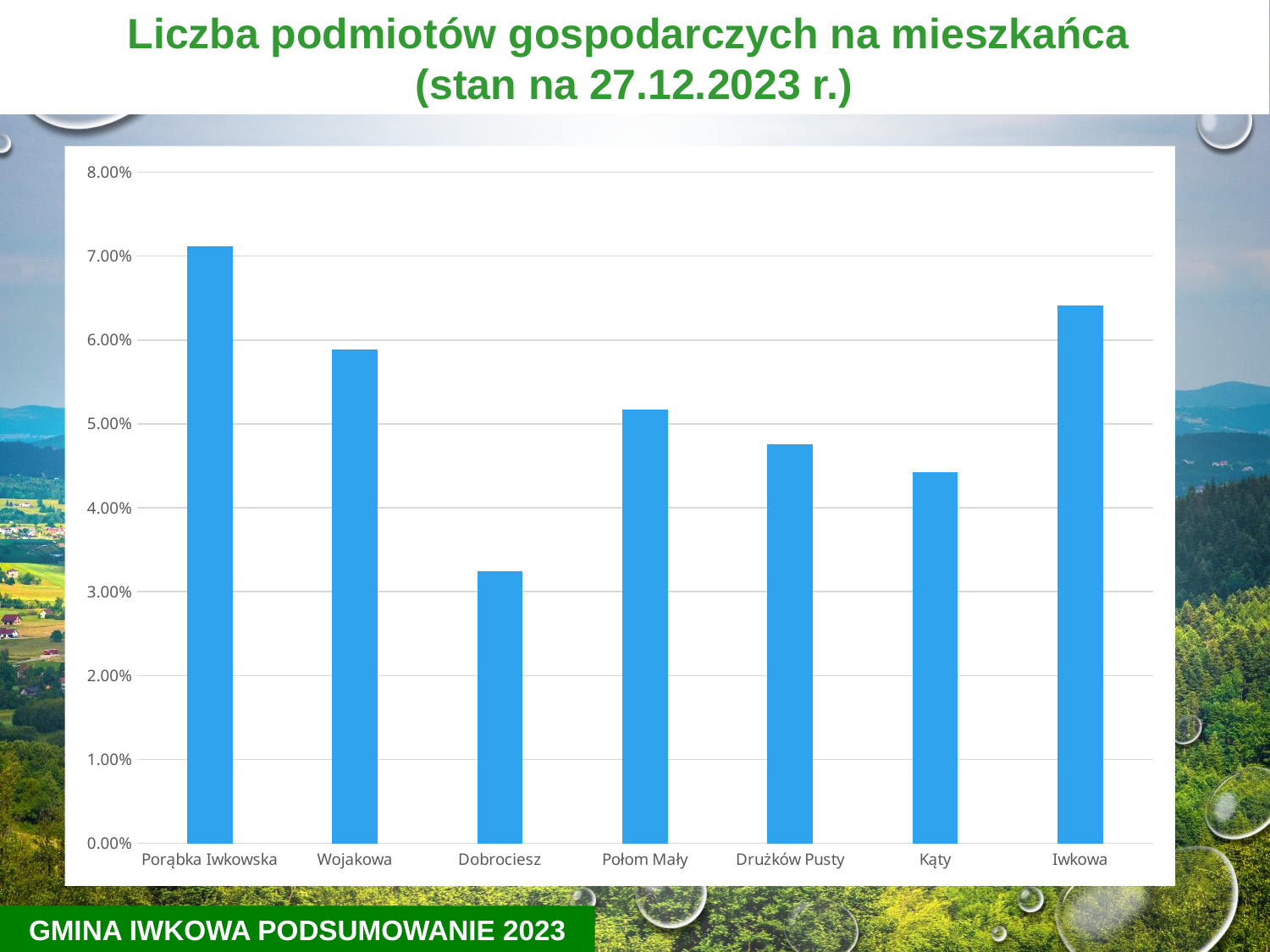
Is the value for Drużków Pusty greater or less than 5.00%? less Which locality has the highest value in the chart? Porąbka Iwkowska How many localities are shown on the x axis of the chart? 7 What is the title of the chart on the slide? Liczba podmiotów gospodarczych na mieszkańca (stan na 27.12.2023 r.) Which has a larger value, Wojakowa or Iwkowa? Iwkowa Is the value for Dobrociesz greater or less than 3.00%? greater Is the value for Porąbka Iwkowska greater or less than 7.00%? greater Which has a larger value, Kąty or Drużków Pusty? Drużków Pusty Which locality has the lowest value in the chart? Dobrociesz What kind of chart is shown on the slide? bar chart